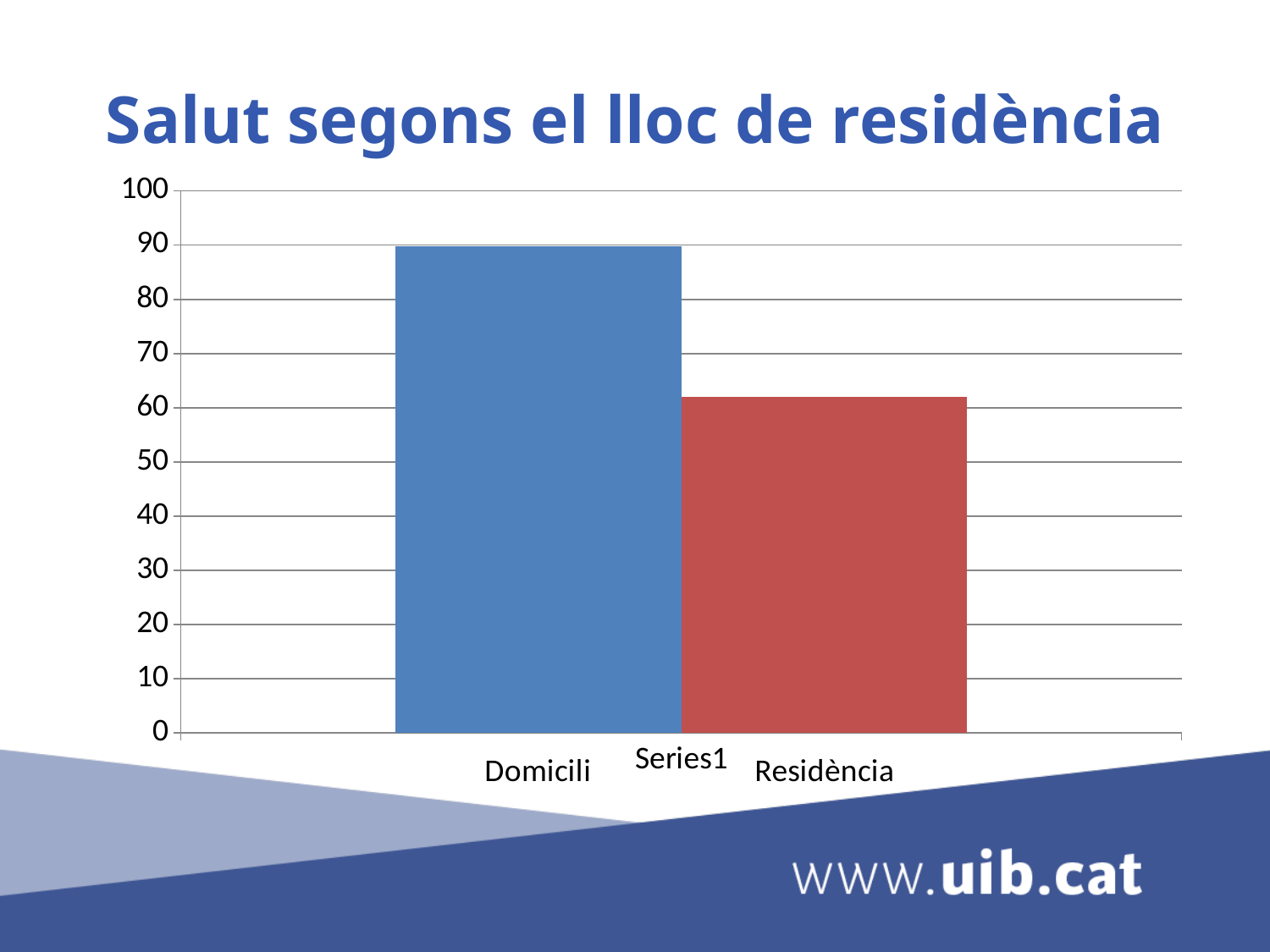
Is the value for Domicili greater or less than 100? less Is the value for Residència greater or less than 70? less What kind of chart is shown on the slide? bar chart How many series does the legend list? 2 Is the value for Domicili greater or less than 80? greater Which is larger, the value for Domicili or the value for Residència? Domicili How many categories are plotted on the x axis? 1 What is the title of the chart? Salut segons el lloc de residència Which category has the lowest bar? Residència What is the name of the series shown in the legend? Domicili and Residència Which category has the highest bar? Domicili